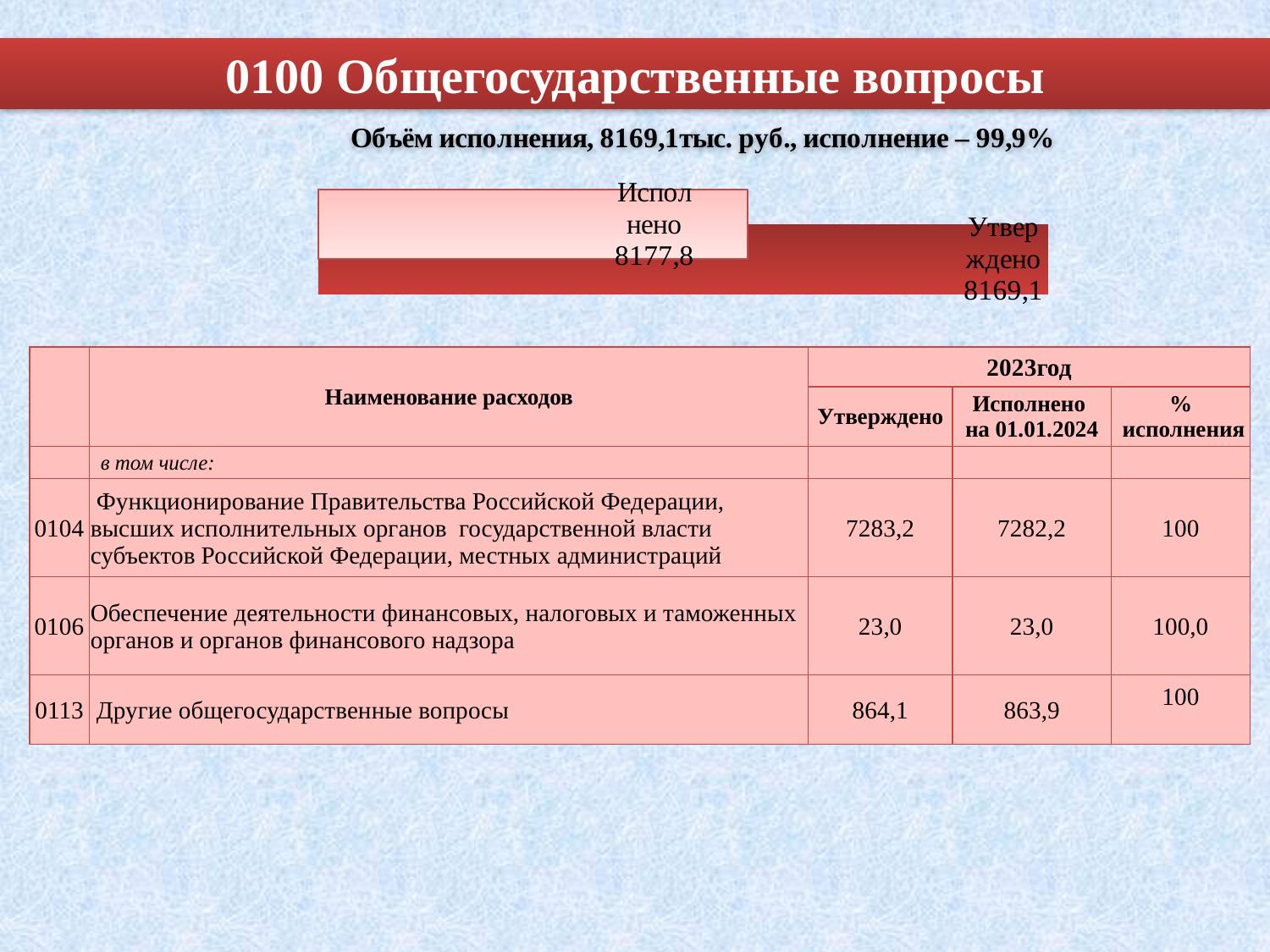
How many bars does the chart show? 2 What colour is the bar labelled Утверждено? dark red What value is labelled on the bar for Исполнено? 8177,8 What value is labelled on the bar for Утверждено? 8169,1 What is the difference between the labelled values for Исполнено (8177,8) and Утверждено (8169,1)? 8,7 What kind of chart is shown on the slide? bar chart Are the bars in the chart horizontal or vertical? horizontal